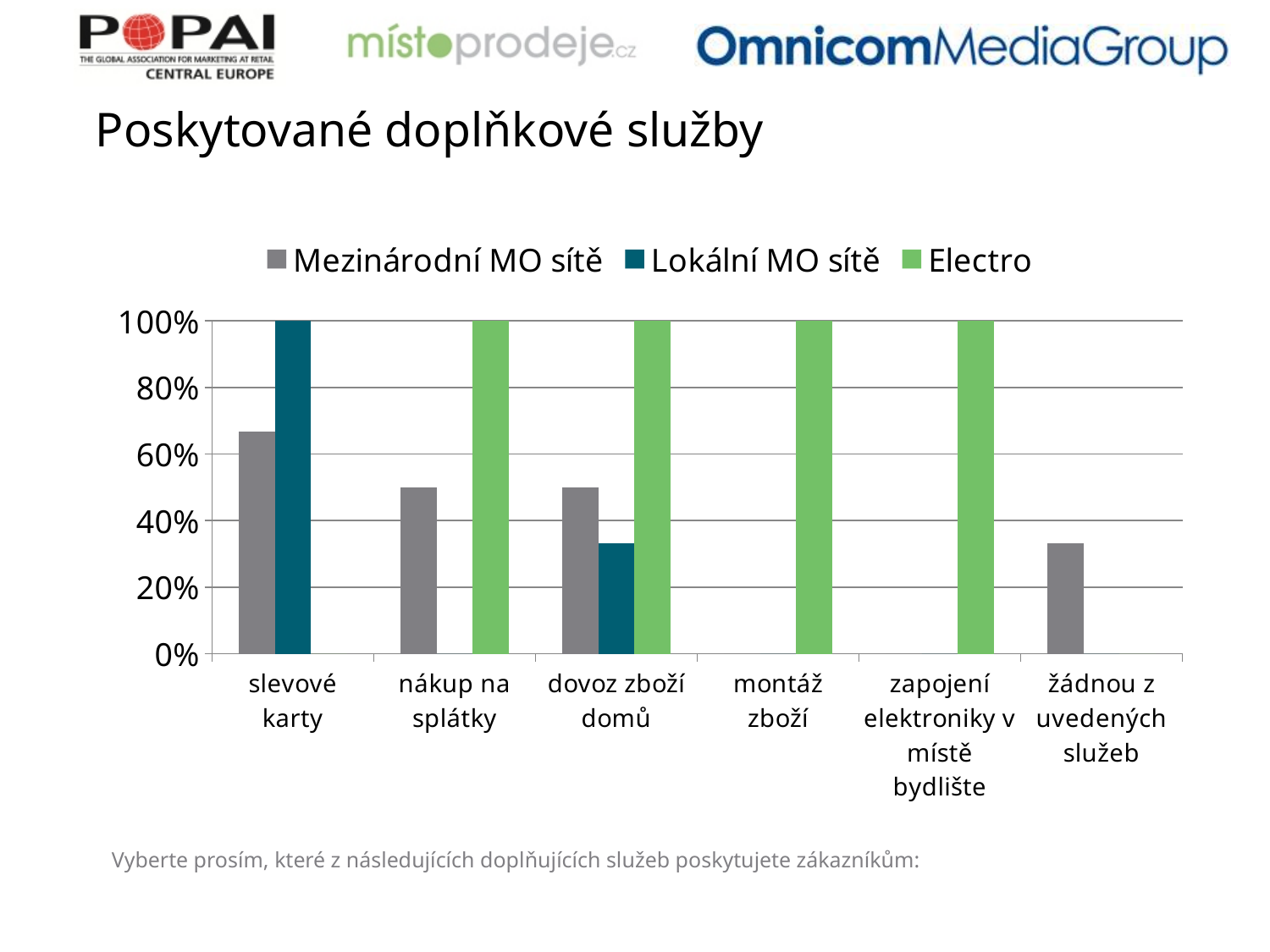
Is the value for Mezinárodní MO sítě in the category slevové karty greater or less than 60%? greater Which series has the higher value in the category dovoz zboží domů, Mezinárodní MO sítě or Lokální MO sítě? Mezinárodní MO sítě Is the value for Mezinárodní MO sítě in the category žádnou z uvedených služeb greater or less than 40%? less How many series does the legend list? 3 Which series has the higher value in the category slevové karty, Mezinárodní MO sítě or Lokální MO sítě? Lokální MO sítě Is the value for Lokální MO sítě in the category dovoz zboží domů greater or less than 40%? less What kind of chart is shown on the slide? bar chart What is the title of the slide containing the chart? Poskytované doplňkové služby What is the value for Electro in the category montáž zboží? 100% How many categories are shown on the x axis? 6 What is the value for Lokální MO sítě in the category slevové karty? 100% In which category does the Mezinárodní MO sítě series reach its highest value? slevové karty